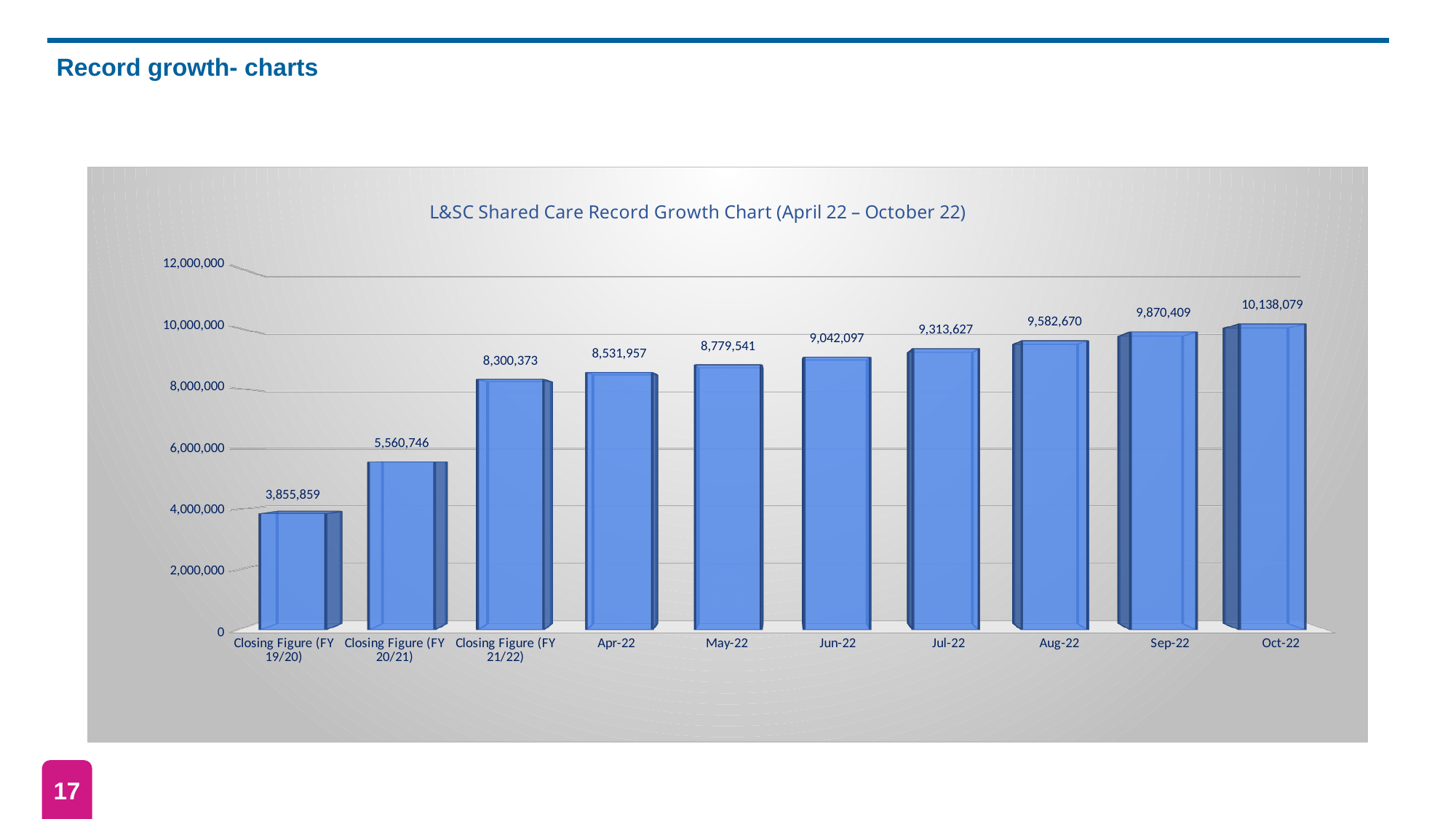
Which category has the highest value? Oct-22 What is the value for Closing Figure (FY 19/20)? 3,855,859 Which is larger, the value for Apr-22 or the value for Closing Figure (FY 21/22)? Apr-22 How many categories are shown on the x axis? 10 What is the difference between the values for Oct-22 and Sep-22? 267,670 What is the difference between the values for Closing Figure (FY 20/21) and Closing Figure (FY 19/20)? 1,704,887 Which category has the lowest value? Closing Figure (FY 19/20) What is the value for Oct-22? 10,138,079 What kind of chart is shown on the slide? bar chart What is the value for Jun-22? 9,042,097 Do the values rise or fall from left to right along the x axis? rise Is the value for Jul-22 greater or less than 10,000,000? less